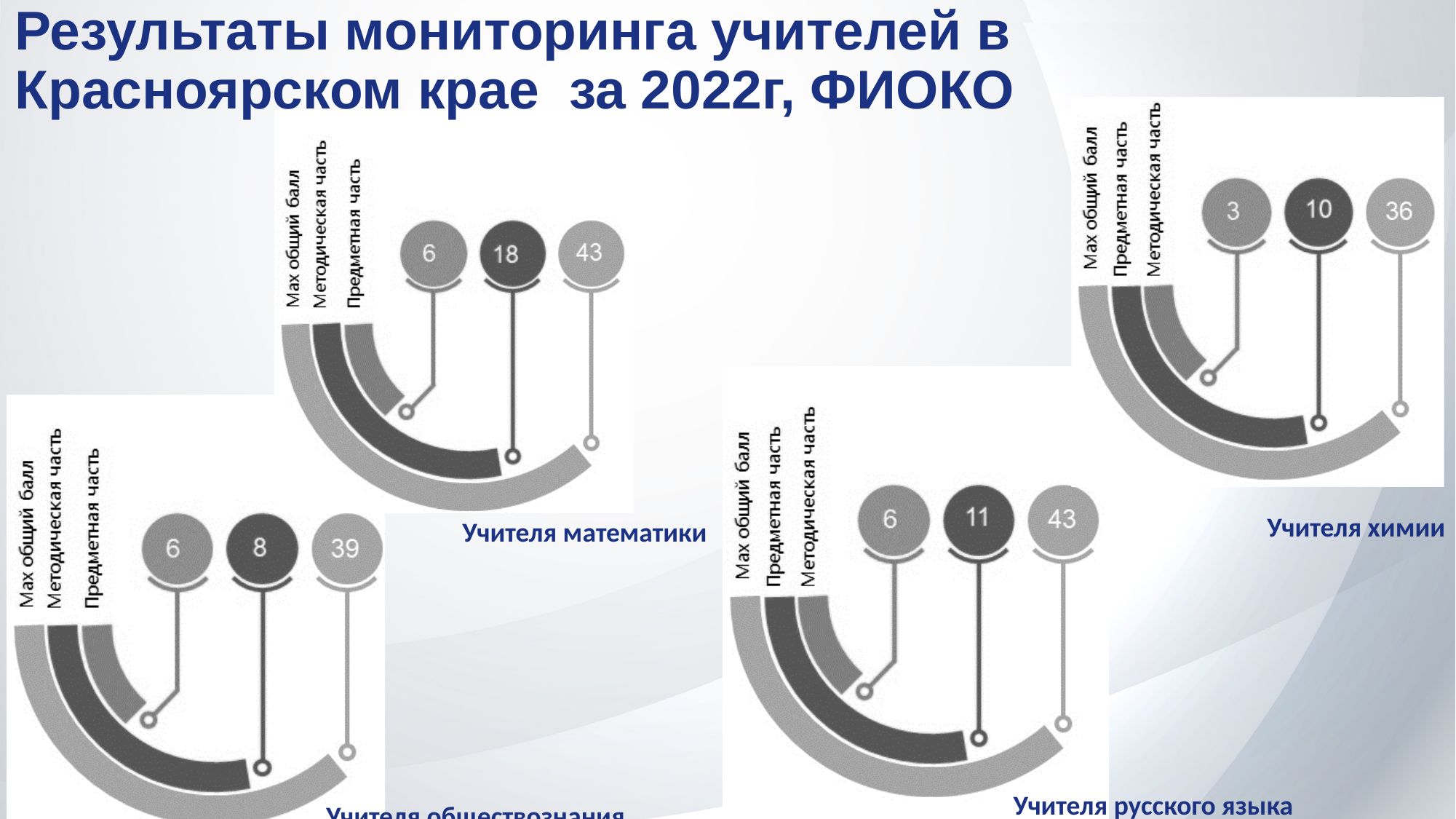
What year do the monitoring results on the slide refer to? 2022 Which subject's teachers does the chart in the top right of the slide refer to? Учителя химии Which is larger: the dark-circle value on the 'Учителя математики' chart or the dark-circle value on the 'Учителя русского языка' chart? Учителя математики On the 'Учителя обществознания' chart, what is the 'Max общий балл' value? 39 On the 'Учителя математики' chart, what value is shown in the dark middle circle? 18 On the 'Учителя русского языка' chart, what is the 'Max общий балл' value? 43 On the 'Учителя математики' chart, what is the largest value shown? 43 What is the difference between the 'Max общий балл' on the 'Учителя русского языка' chart (43) and on the 'Учителя обществознания' chart (39)? 4 How many charts are shown on the slide? 4 How many values are shown on the 'Учителя химии' chart? 3 On the 'Учителя химии' chart, what is the smallest value shown? 3 On the 'Учителя химии' chart, what is the 'Max общий балл' value? 36